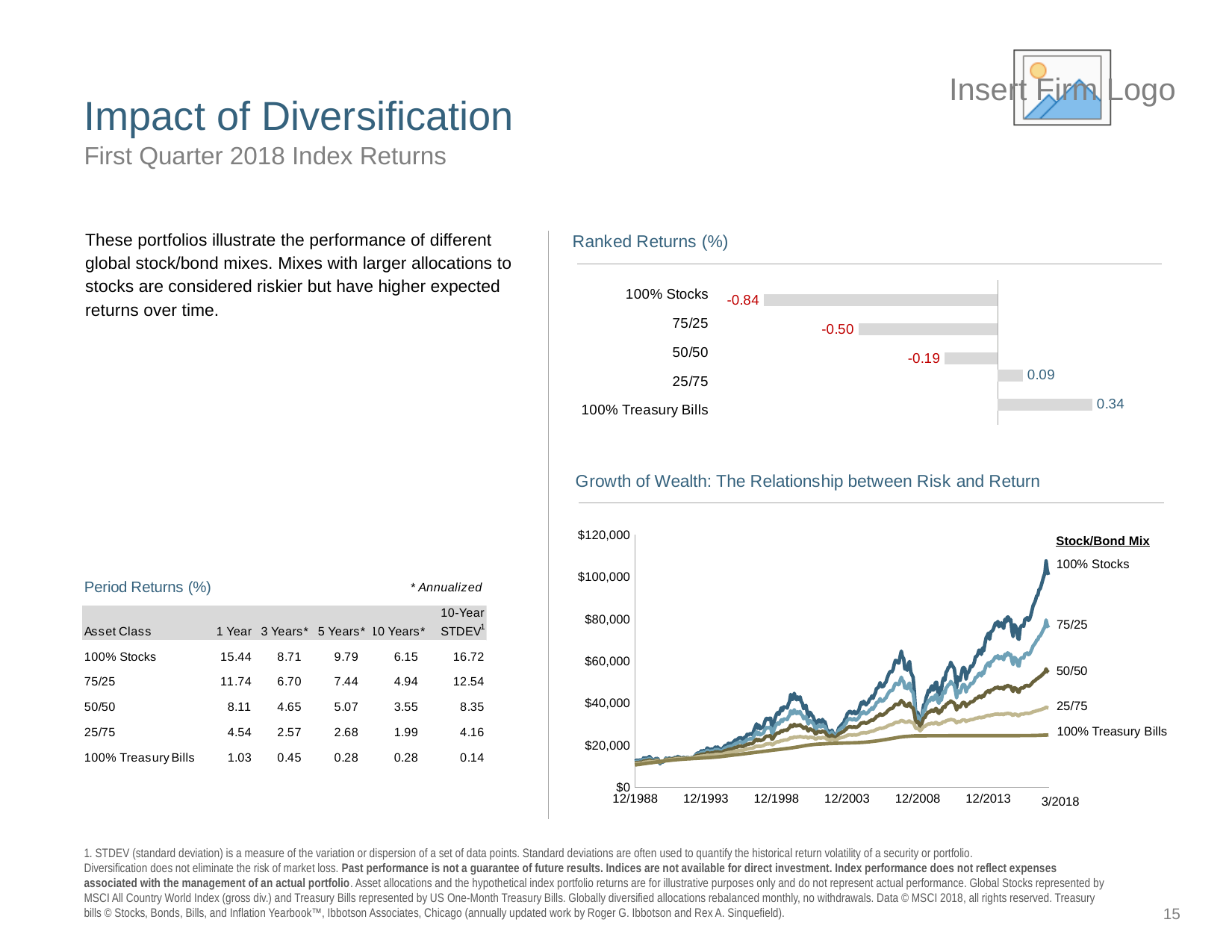
In the Ranked Returns (%) chart, which is larger, the value for 50/50 or the value for 75/25? 50/50 In the Ranked Returns (%) chart, what is the value for 100% Stocks? -0.84 In the Ranked Returns (%) chart, which portfolio has the highest return? 100% Treasury Bills In the Growth of Wealth chart, is the ending value for 100% Stocks at 3/2018 greater or less than $100,000? greater What kind of chart is the Ranked Returns (%) chart? Bar chart In the Ranked Returns (%) chart, what is the value for 50/50? -0.19 In the Ranked Returns (%) chart, what is the difference between the values for 25/75 and 75/25? 0.59 How many portfolios are shown in the Ranked Returns (%) chart? 5 What kind of chart is the Growth of Wealth chart? Line chart How many stock/bond mixes are plotted in the Growth of Wealth chart? 5 In the Ranked Returns (%) chart, what is the value for 100% Treasury Bills? 0.34 In the Ranked Returns (%) chart, which portfolio has the lowest return? 100% Stocks